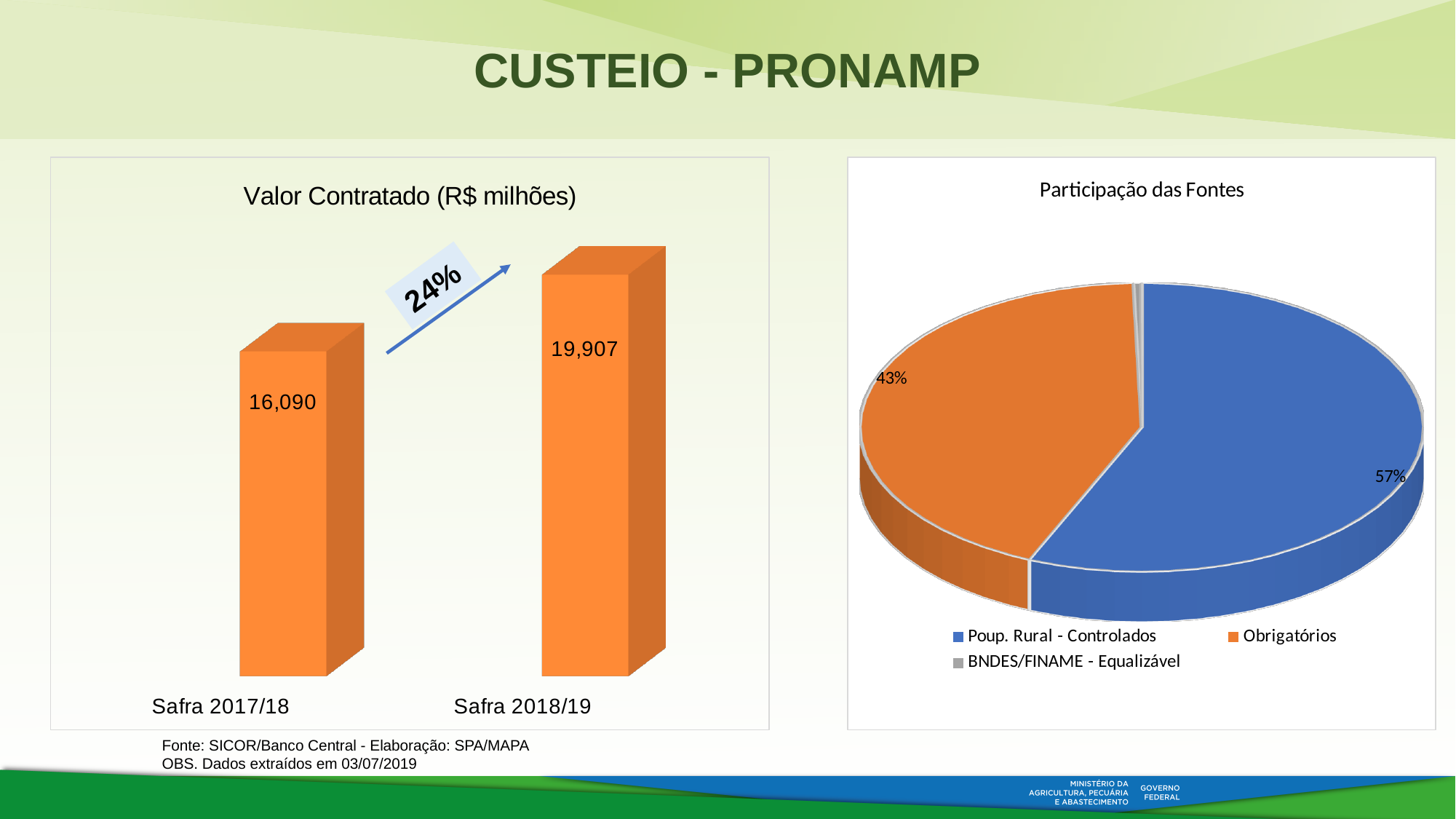
In the 'Valor Contratado (R$ milhões)' chart, what is the difference between Safra 2018/19 and Safra 2017/18? 3,817 What kind of chart is 'Valor Contratado (R$ milhões)'? Bar chart In the 'Valor Contratado (R$ milhões)' chart, how many bars are plotted? 2 In the 'Participação das Fontes' chart, what share does Obrigatórios have? 43% In the 'Valor Contratado (R$ milhões)' chart, what is the value for Safra 2018/19? 19,907 In the 'Valor Contratado (R$ milhões)' chart, do the values rise or fall from Safra 2017/18 to Safra 2018/19? Rise In the 'Valor Contratado (R$ milhões)' chart, which safra has the higher value? Safra 2018/19 In the 'Valor Contratado (R$ milhões)' chart, what percentage change is shown by the arrow between the two bars? 24% In the 'Valor Contratado (R$ milhões)' chart, which safra has the lower value? Safra 2017/18 In the 'Valor Contratado (R$ milhões)' chart, what is the value for Safra 2017/18? 16,090 In the 'Participação das Fontes' chart, what share does Poup. Rural - Controlados have? 57% How many entries does the legend of the 'Participação das Fontes' chart list? 3